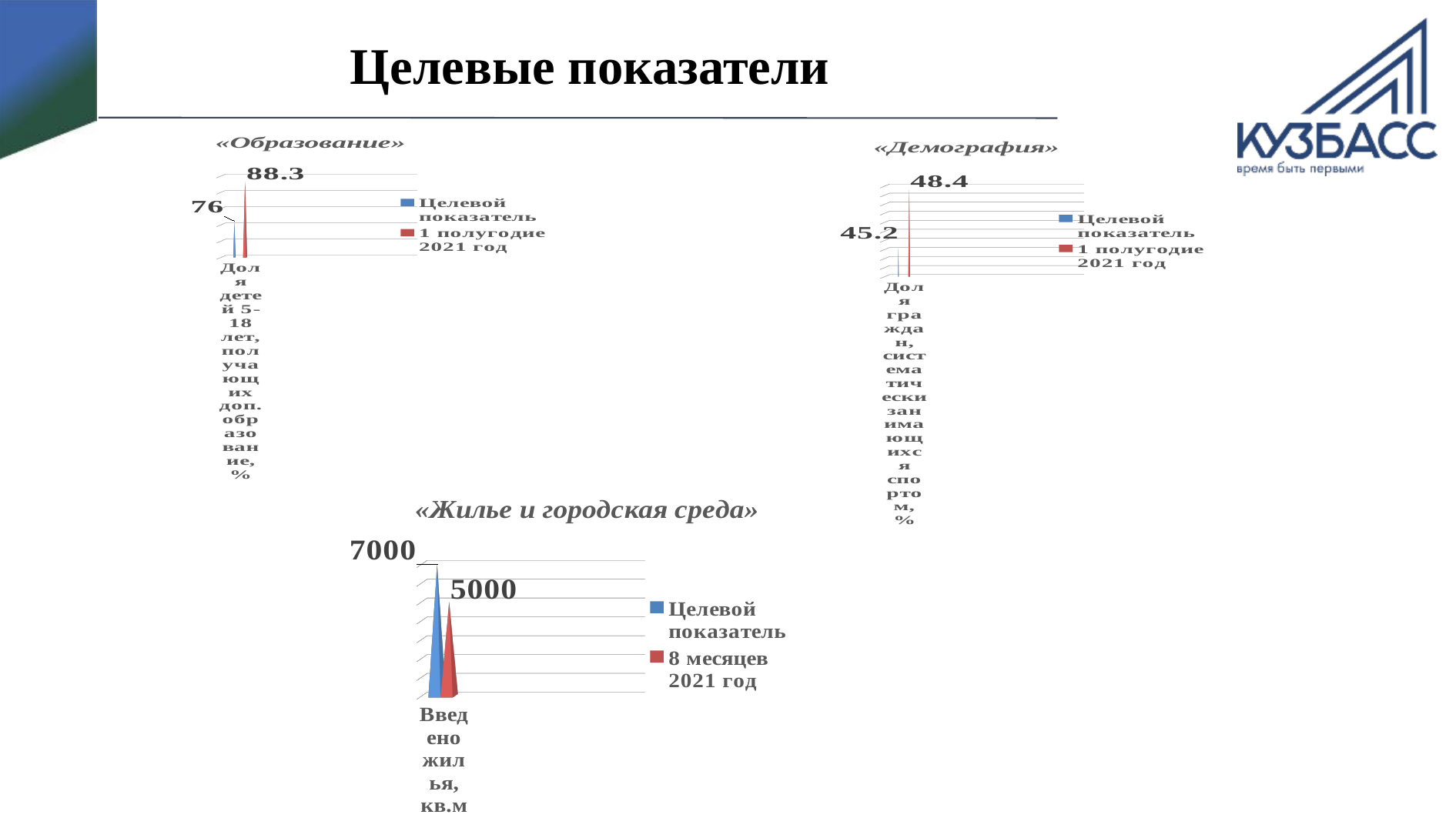
In the «Жилье и городская среда» chart, what is the value for «8 месяцев 2021 год»? 5000 In the «Демография» chart, what is the value for «Целевой показатель»? 45.2 How many series does the legend of the «Жилье и городская среда» chart list? 2 In the «Жилье и городская среда» chart, what is the value for «Целевой показатель»? 7000 In the «Образование» chart, what is the value for «1 полугодие 2021 год»? 88.3 What kind of chart is the «Демография» chart? Bar chart In the «Демография» chart, which is larger: «Целевой показатель» or «1 полугодие 2021 год»? 1 полугодие 2021 год In the «Демография» chart, what is the value for «1 полугодие 2021 год»? 48.4 In the «Образование» chart, what is the value for «Целевой показатель»? 76 In the «Образование» chart, what is the difference between the «1 полугодие 2021 год» value and the «Целевой показатель» value? 12.3 In the «Жилье и городская среда» chart, which series has the higher value? Целевой показатель In the «Жилье и городская среда» chart, what is the difference between «Целевой показатель» and «8 месяцев 2021 год»? 2000